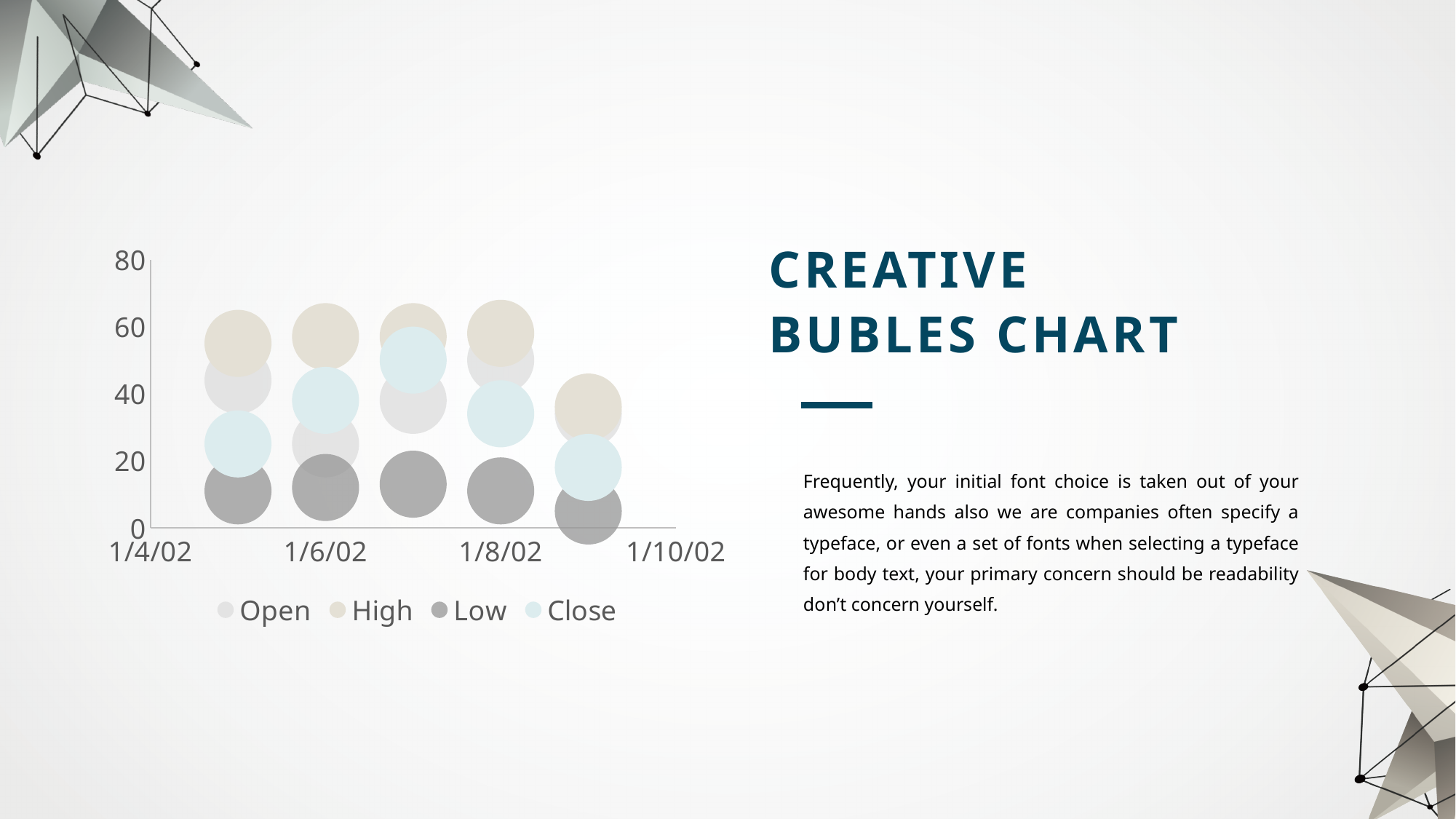
Is the value of the Close series at 1/8/02 greater or less than 60? less What kind of chart is shown on the slide? bubble chart What are the series names listed in the chart legend? Open, High, Low, Close Which series has the lowest value at 1/8/02? Low How many series does the chart legend list? 4 At 1/6/02, which is larger: the High series value or the Low series value? High How many date labels are shown on the chart's horizontal axis? 4 Is the value of the High series at 1/8/02 greater or less than 40? greater What is the highest value shown on the chart's vertical axis? 80 Is the value of the Low series at 1/6/02 greater or less than 20? less Which series has the highest value at 1/6/02? High